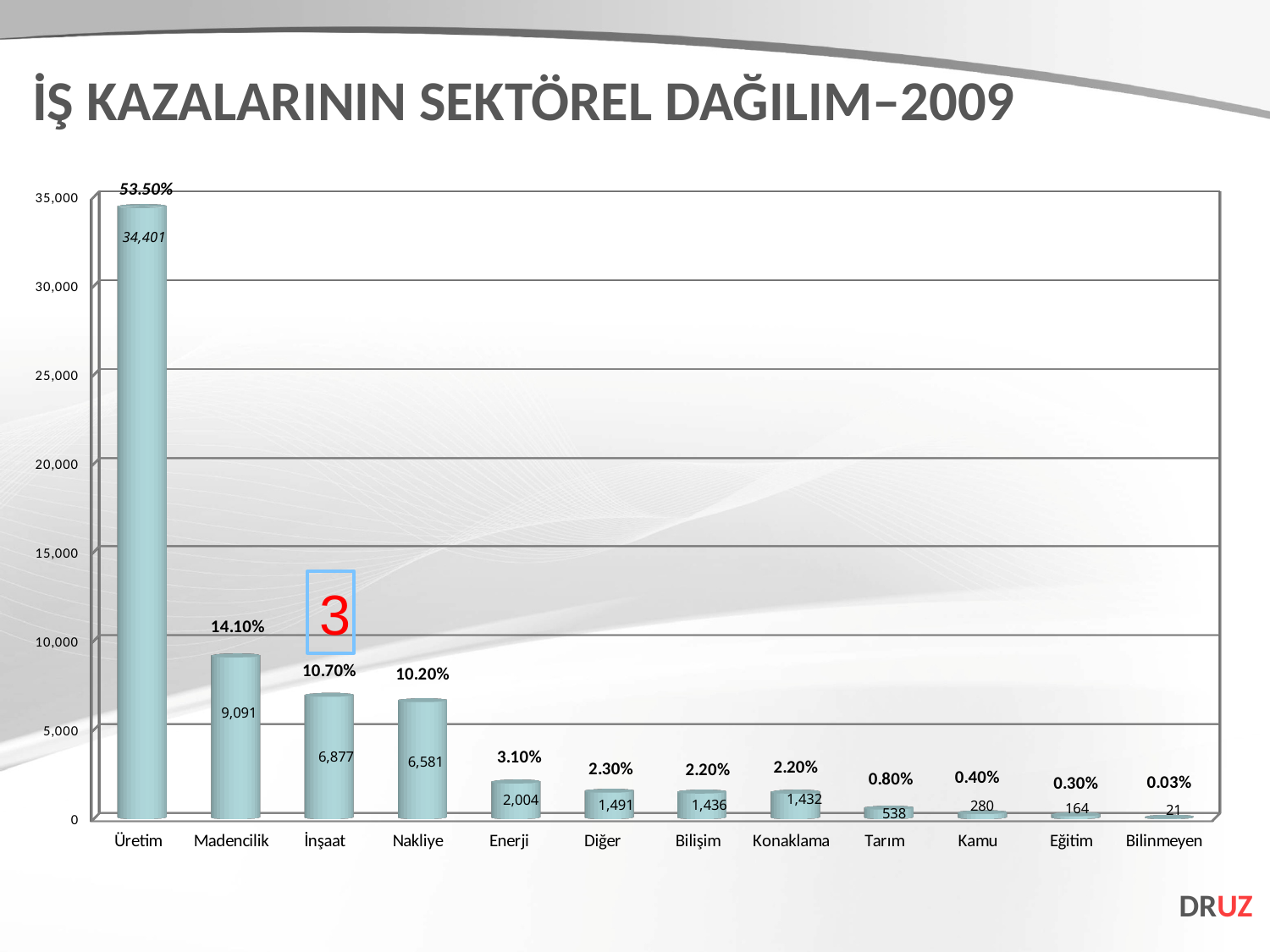
Which category has the highest value? Üretim Which category has the lowest value? Bilinmeyen Is the value for Madencilik greater or less than 10,000? less What is the title of the slide? İŞ KAZALARININ SEKTÖREL DAĞILIM–2009 What is the value shown for Nakliye? 6,581 What kind of chart is shown on the slide? bar chart What percentage is shown above the Madencilik bar? 14.10% Which is larger, the value for Enerji or the value for Diğer? Enerji How many categories are shown on the x axis? 12 What is the value shown for Üretim? 34,401 What is the difference between the values for Madencilik and İnşaat? 2,214 What is the value shown for Bilinmeyen? 21